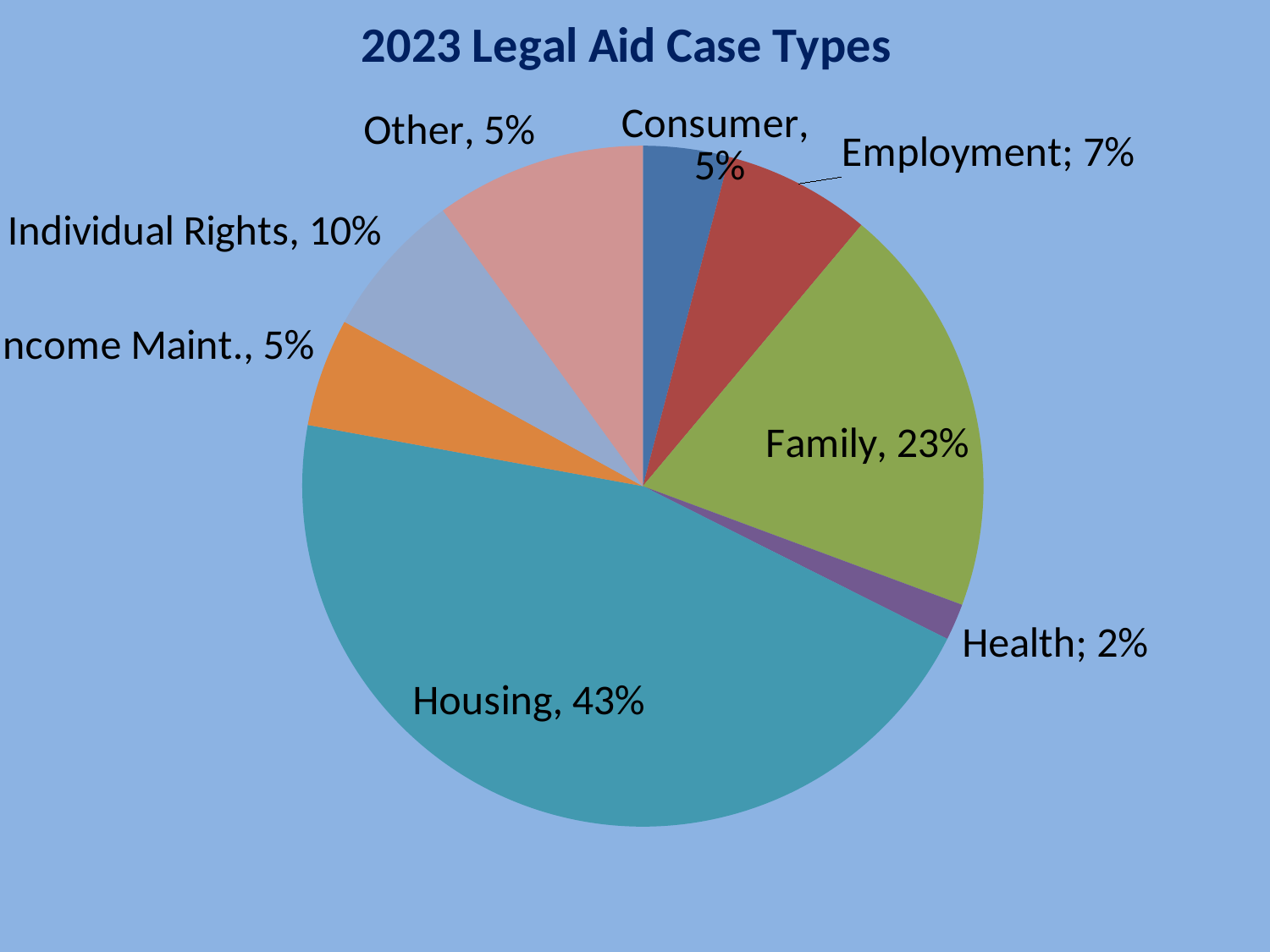
Which case type has the smallest share of the pie? Health What type of chart is shown on the slide? Pie chart What percentage of cases is Employment? 7% What percentage of cases is Housing? 43% What percentage of cases is Individual Rights? 10% Which case type has the largest share of the pie? Housing How many slices does the pie chart have? 8 What is the title of the chart? 2023 Legal Aid Case Types Which is larger, the share for Employment or the share for Consumer? Employment What is the difference in percentage points between Housing and Family? 20 What is the combined share of Family and Health? 25% What percentage of cases is Family? 23%